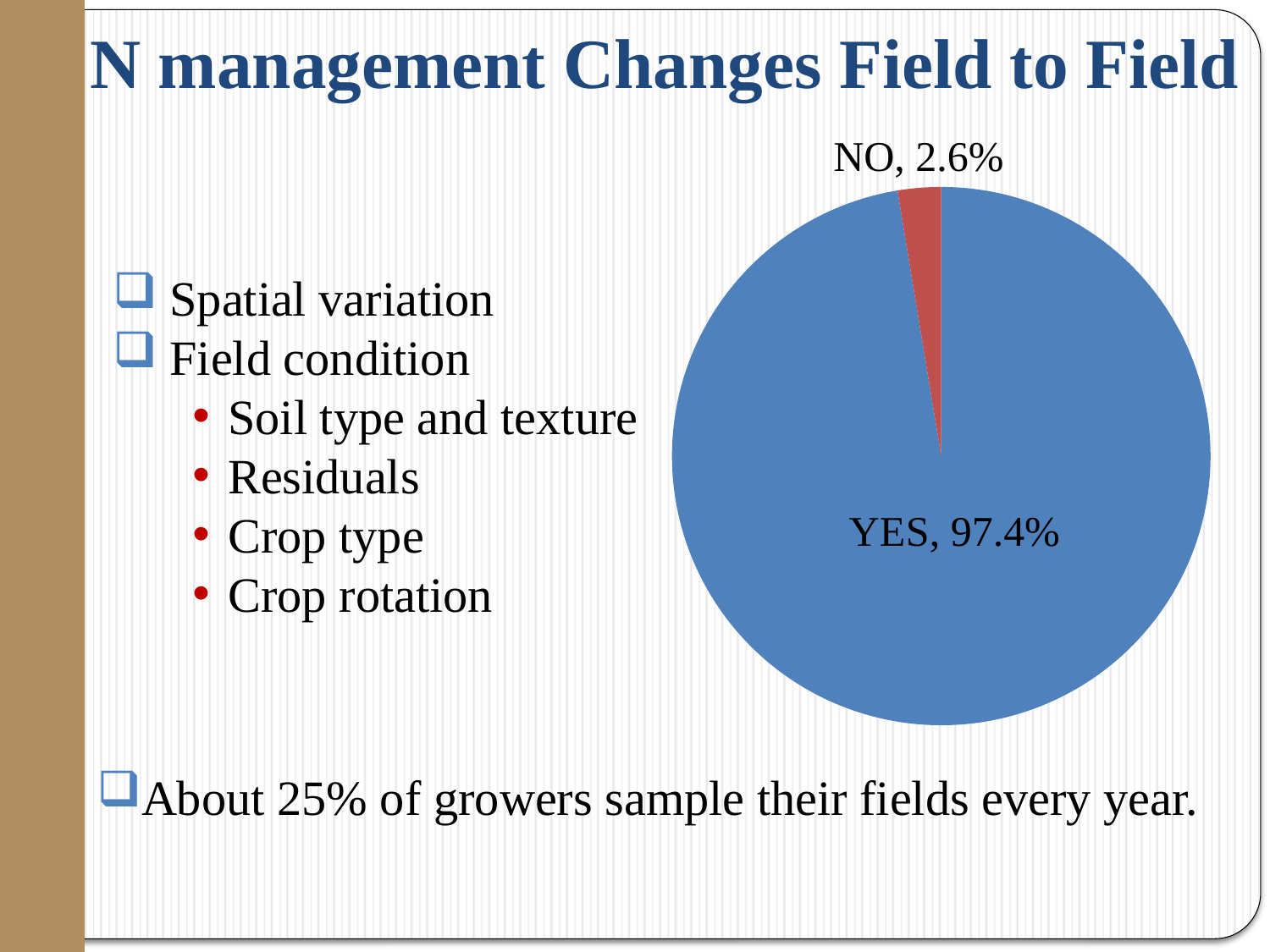
Which slice of the pie chart is the largest? YES What share of the pie does the NO slice represent? 2.6% Which is larger in the pie chart, YES or NO? YES How many slices does the pie chart have? 2 Which slice of the pie chart is the smallest? NO What is the value for YES in the pie chart? 97.4% What colour is the YES slice in the pie chart? blue What is the difference between the YES and NO values in the pie chart? 94.8% What kind of chart is shown on the slide? pie chart What is the value for NO in the pie chart? 2.6% What colour is the NO slice in the pie chart? red